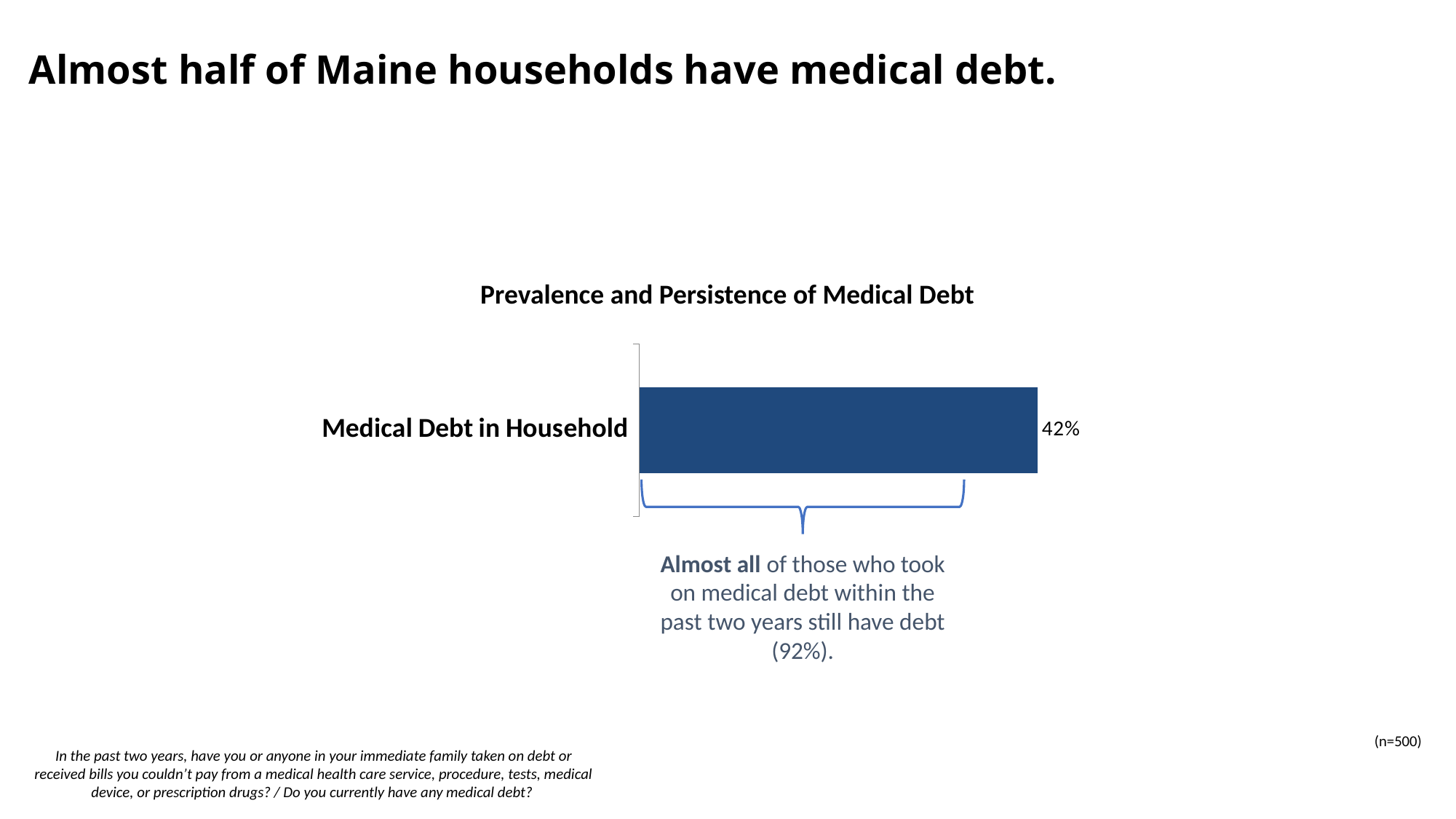
What is the label of the single bar in the chart? Medical Debt in Household How many categories does the chart show? 1 What kind of chart is shown on the slide? bar chart Is the value for Medical Debt in Household greater or less than 50%? less What is the sample size (n) shown on the slide? 500 What is the title of the chart? Prevalence and Persistence of Medical Debt What is the value for Medical Debt in Household? 42% According to the annotation under the bar, what percentage of those who took on medical debt within the past two years still have debt? 92%